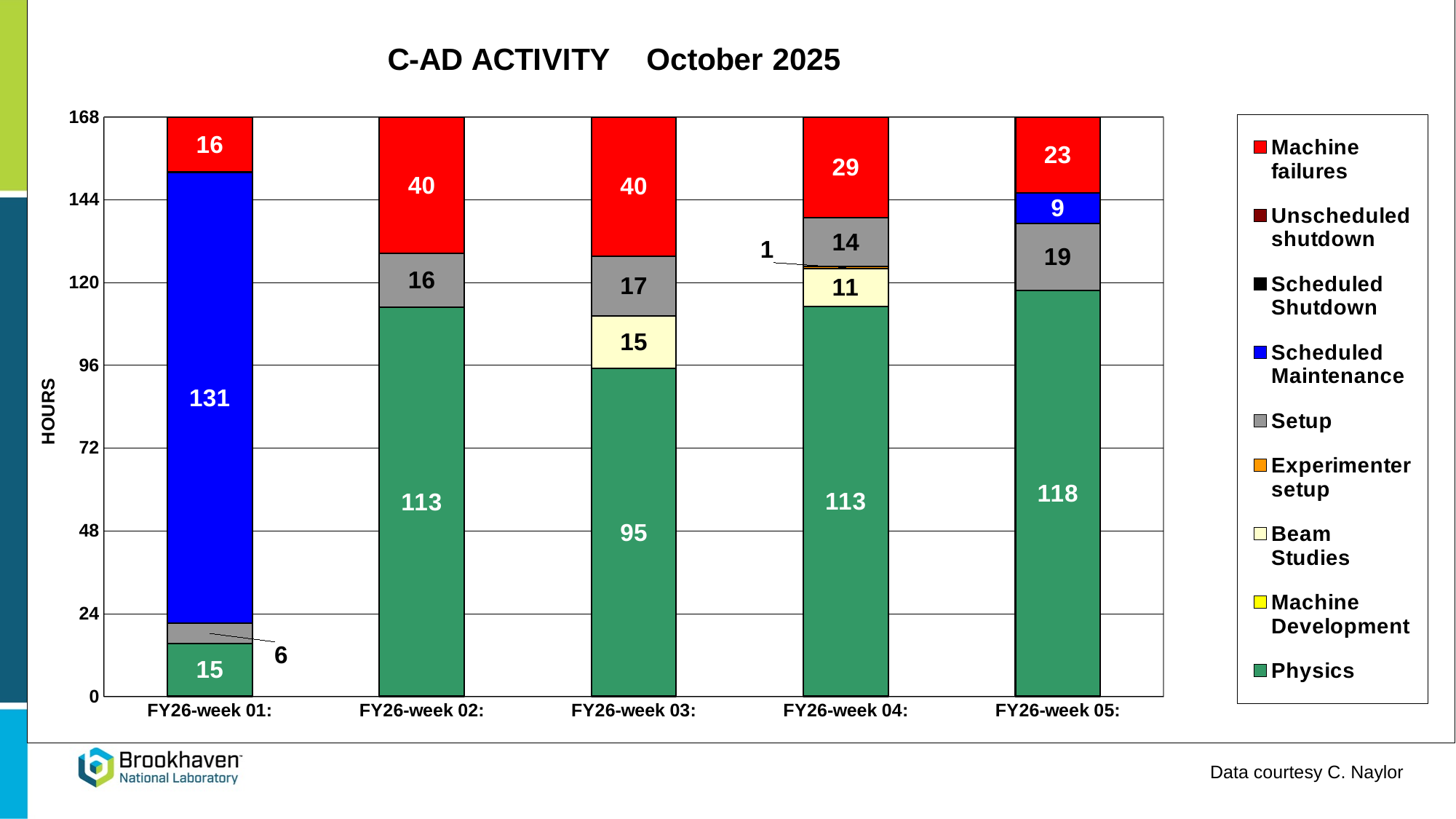
Which week has the lowest number of Physics hours? FY26-week 01 How many weeks (categories) are plotted along the x axis? 5 What kind of chart is shown on the slide? Stacked bar chart Which week has the highest number of Physics hours? FY26-week 05 How many series does the legend list? 9 How many hours of Beam Studies are shown for FY26-week 04? 11 What is the label on the y axis? HOURS What is the difference in Machine failures hours between FY26-week 02 and FY26-week 05? 17 How many hours of Physics are shown for FY26-week 03? 95 How many hours of Scheduled Maintenance are shown for FY26-week 01? 131 Which week has more Setup hours, FY26-week 02 or FY26-week 05? FY26-week 05